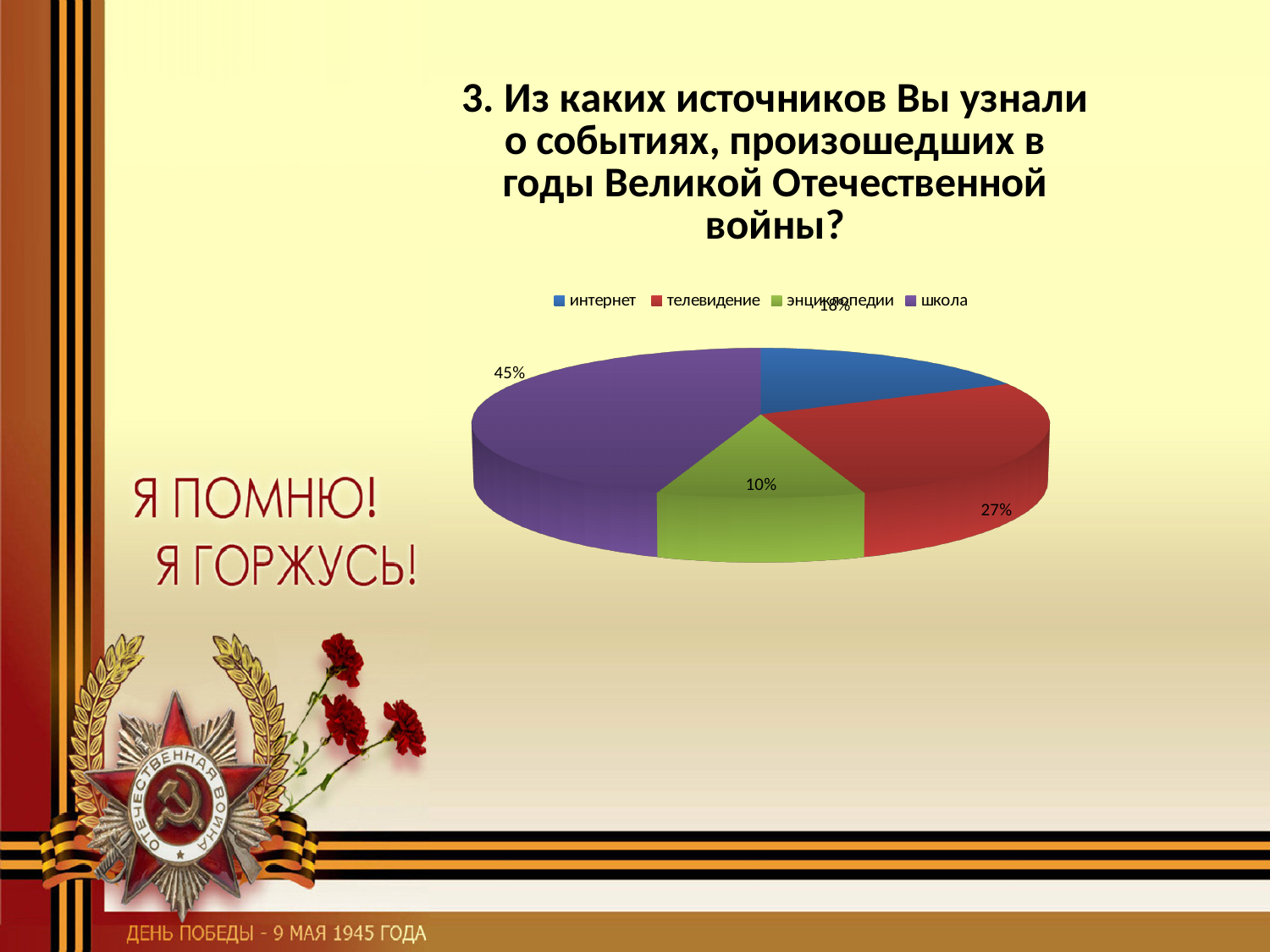
What share of the pie does the "школа" slice have? 45% Which legend entry is shown in red? телевидение What kind of chart is shown on the slide? pie chart What is the value shown for "энциклопедии"? 10% What colour is the "школа" slice in the pie chart? purple How many categories does the legend of the pie chart list? 4 Which category has the largest slice of the pie? школа Which category has the smallest slice of the pie? энциклопедии By how many percentage points does "школа" exceed "телевидение"? 18% Which is larger, the slice for "школа" or the slice for "телевидение"? школа What is the difference between the values for "телевидение" and "энциклопедии"? 17% What is the value shown for "телевидение"? 27%